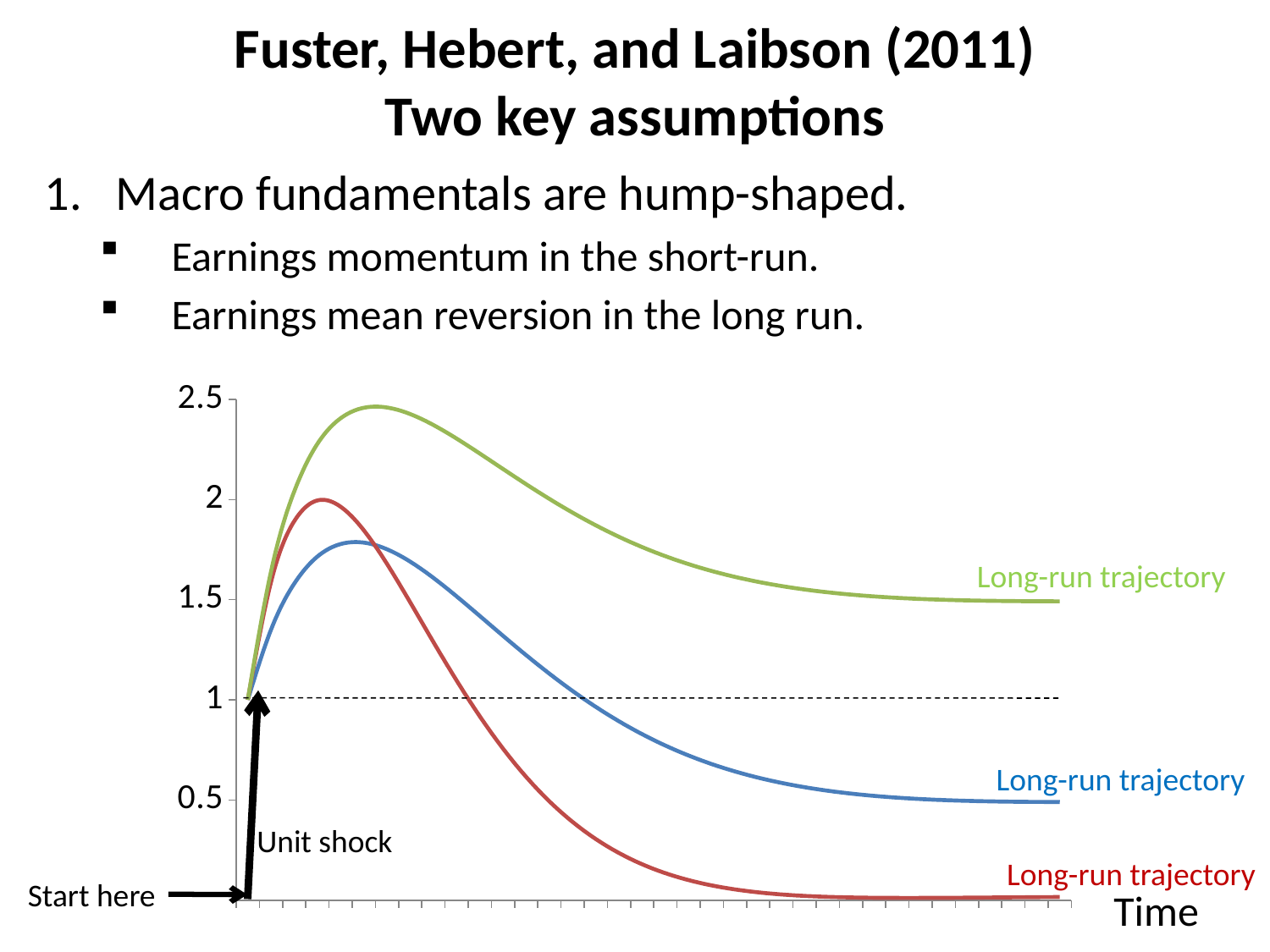
What kind of chart is shown on the slide? line chart Which coloured line ends at the lowest long-run level on the chart? red How many curved lines are plotted on the chart? 3 Is the long-run level of the blue line greater or less than 1? less What is the highest value shown on the vertical axis of the chart? 2.5 Is the long-run level of the red line greater or less than 0.5? less Do the plotted lines rise and then fall, or fall and then rise, as time increases? rise and then fall What is the label on the horizontal axis of the chart? Time Which coloured line reaches the highest peak on the chart? green Is the long-run level of the green line greater or less than 1? greater